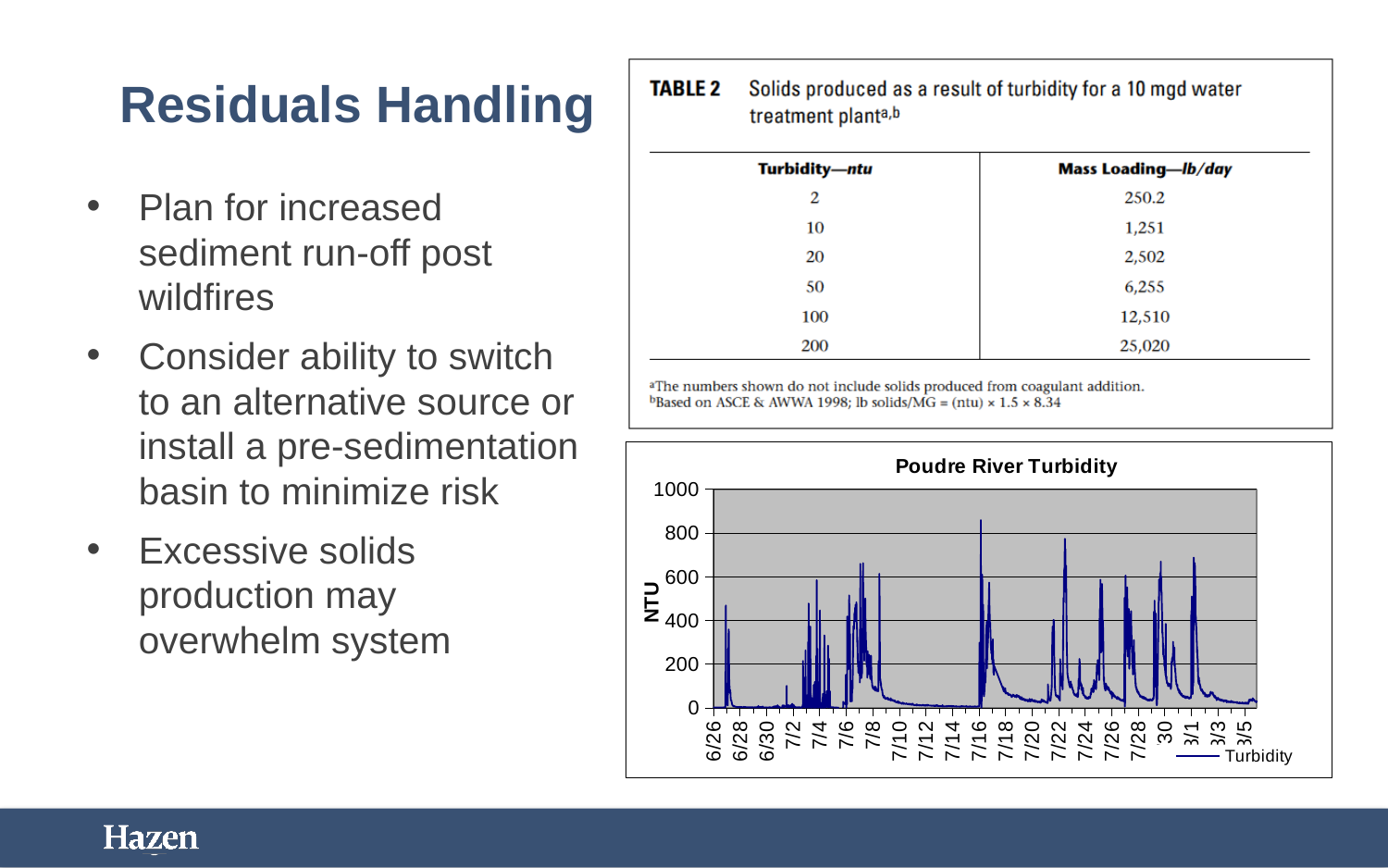
On the Poudre River Turbidity chart, is the turbidity on 6/30 greater or less than 200? less On the Poudre River Turbidity chart, is the turbidity around 7/12 greater or less than 200? less How many series does the legend of the Poudre River Turbidity chart list? 1 What is the title of the line chart on the slide? Poudre River Turbidity What kind of chart is the Poudre River Turbidity chart? line chart On the Poudre River Turbidity chart, is the highest peak (around 7/16) greater or less than 800? greater What is the legend entry on the Poudre River Turbidity chart? Turbidity On the Poudre River Turbidity chart, what is the highest value shown on the y axis? 1000